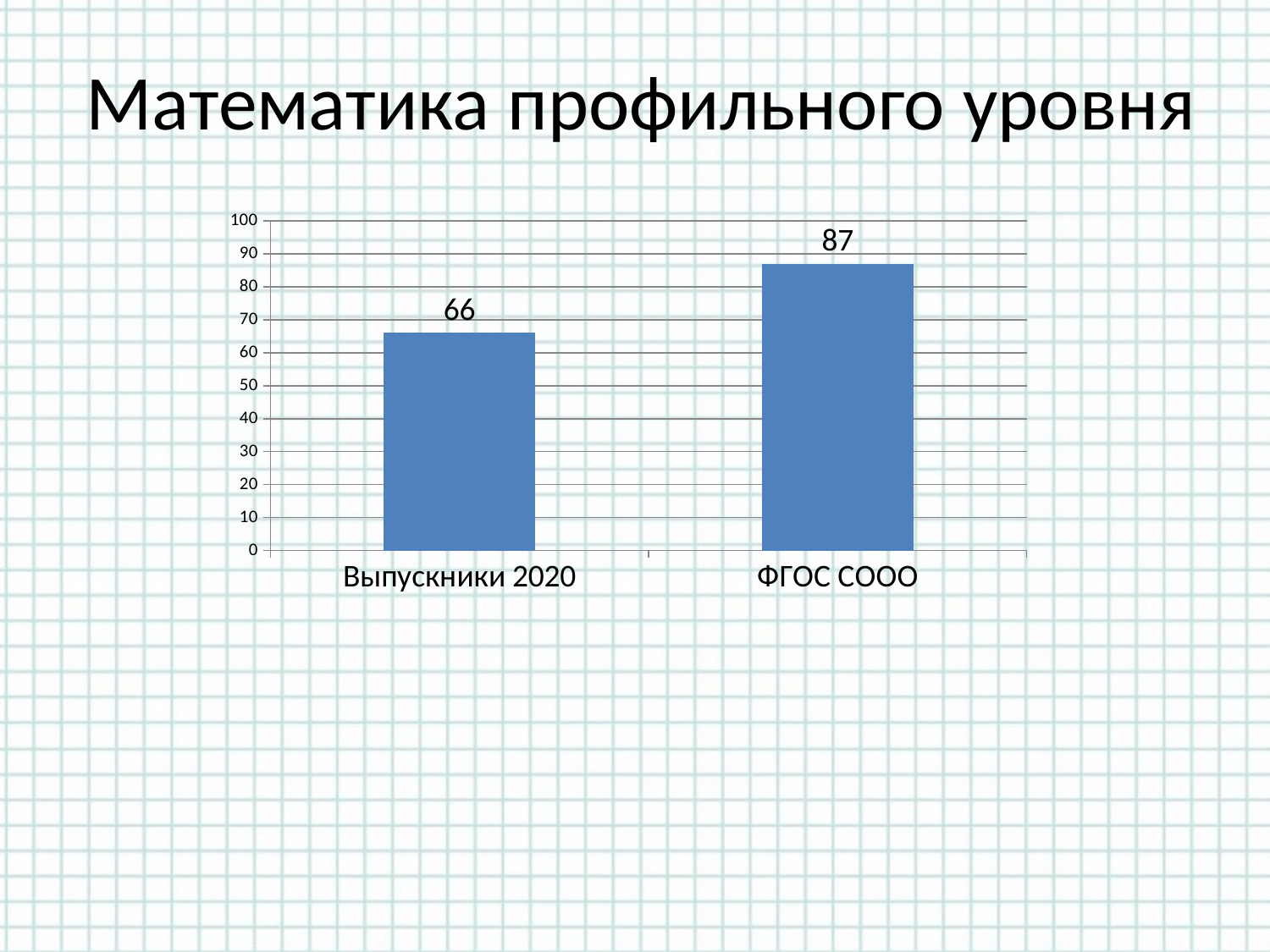
Which category has the highest value? ФГОС СООО How many categories are shown on the chart? 2 What is the value for Выпускники 2020? 66 What is the value for ФГОС СООО? 87 What is the title of the slide? Математика профильного уровня What is the maximum value shown on the vertical axis? 100 What kind of chart is shown on the slide? bar chart Is the value for Выпускники 2020 greater or less than 70? less Which category has the lowest value? Выпускники 2020 Is the value for ФГОС СООО greater or less than 80? greater What is the difference between the values for ФГОС СООО and Выпускники 2020? 21 Which is larger, the value for Выпускники 2020 or the value for ФГОС СООО? ФГОС СООО